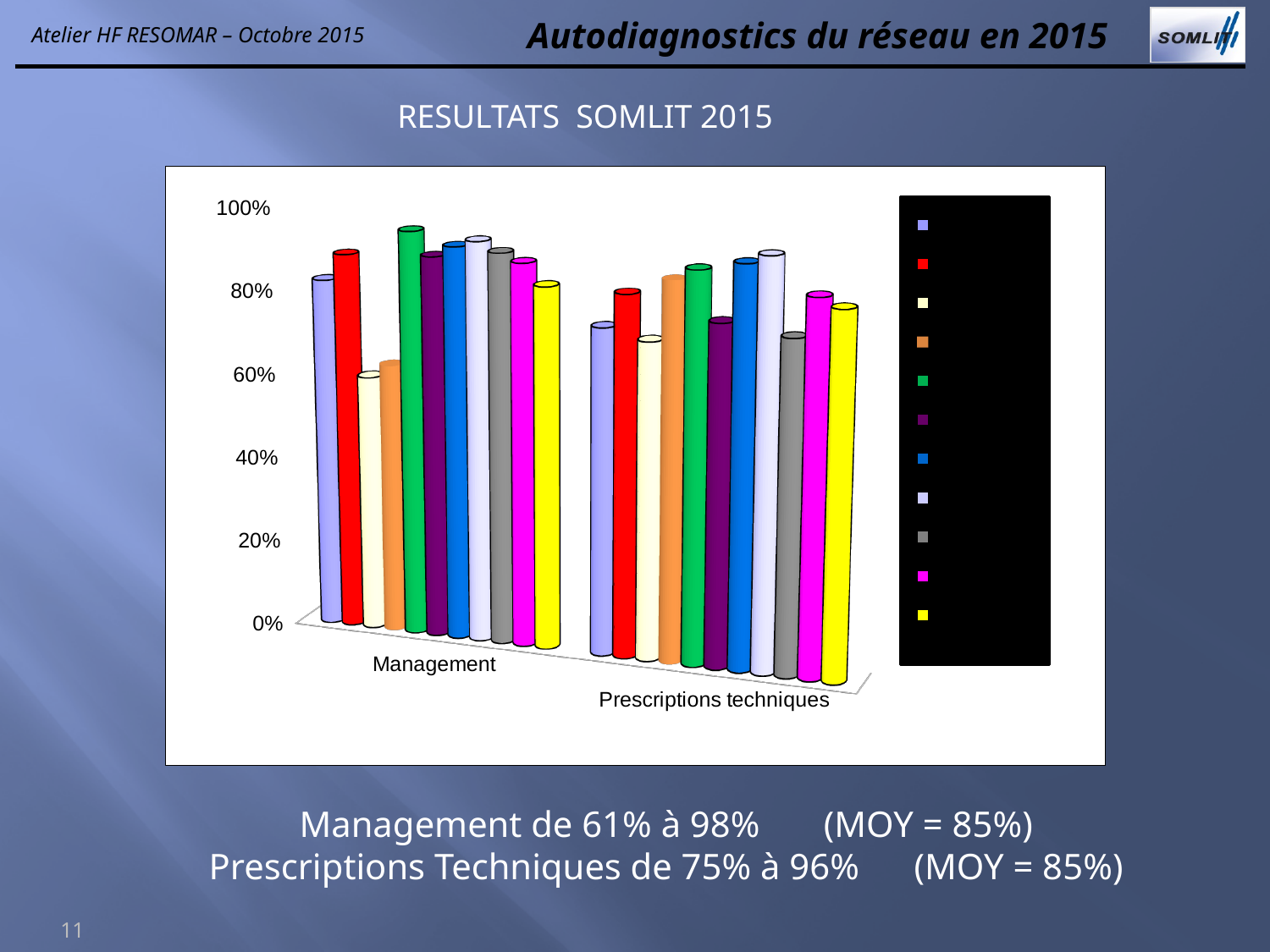
Is the value of the orange bar for Management greater or less than 80%? less What kind of chart is shown on the slide? bar chart What are the two categories shown on the x axis of the chart? Management and Prescriptions techniques Within the Management category, which is larger: the green bar or the orange bar? the green bar Is the value of the cream-coloured bar for Management greater or less than 80%? less How many series does the chart's legend list? 11 What is the highest value shown on the chart's vertical axis? 100% How many categories are shown on the x axis of the chart? 2 Is the value of the cream-coloured bar for Prescriptions techniques greater or less than 60%? greater